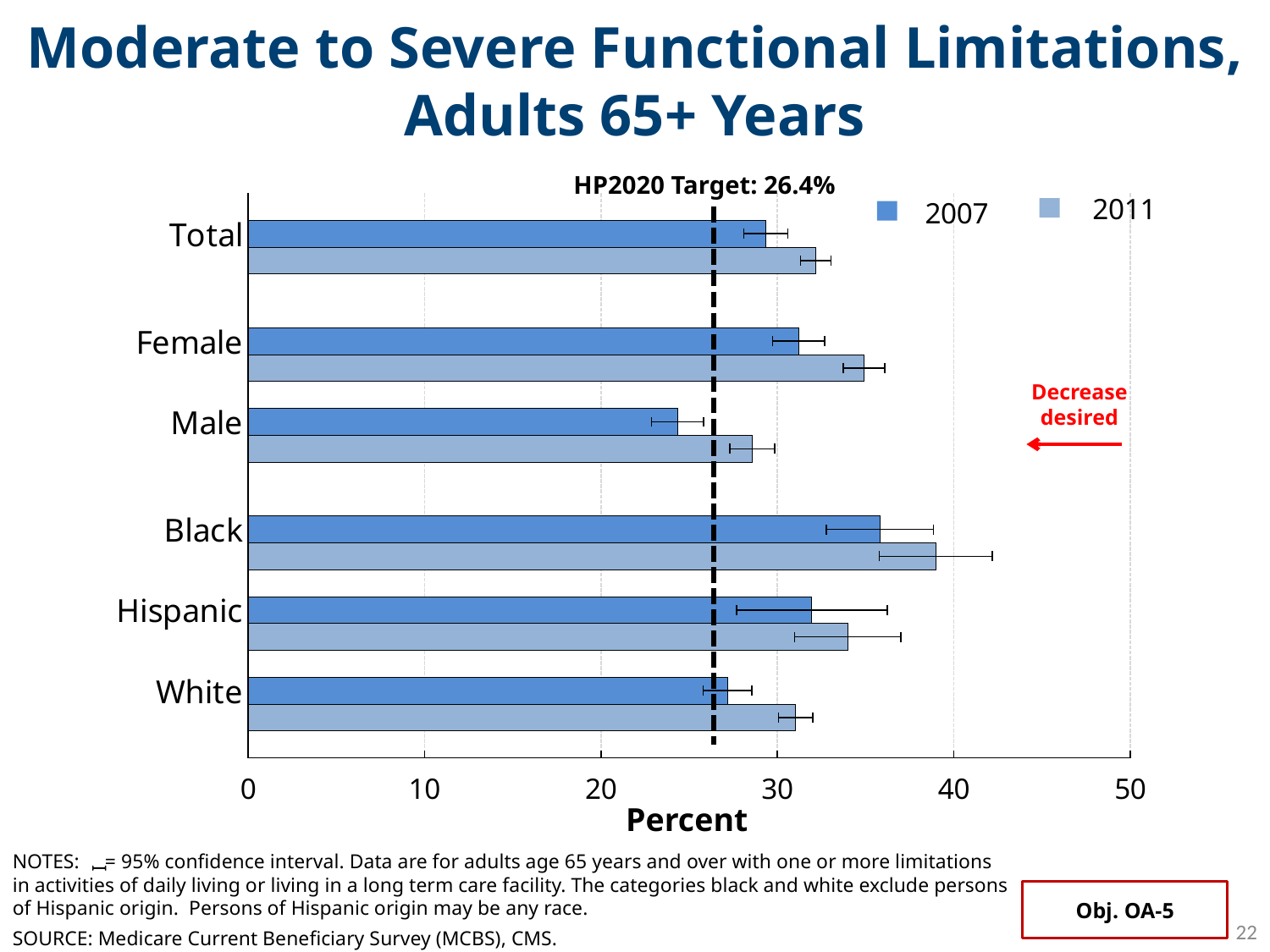
Which category has the lowest 2007 value? Male What is the HP2020 Target value shown on the chart? 26.4% Is the 2011 value for Female greater or less than 30? greater How many categories are shown on the vertical axis? 6 Which category has the highest 2011 value? Black What is the title of the horizontal axis? Percent Is the 2007 value for Male greater or less than 30? less For 2011, which is larger: the value for Female or the value for Male? Female How many series does the legend list? 2 Is the 2011 value for Black greater or less than 30? greater What kind of chart is shown on the slide? bar chart